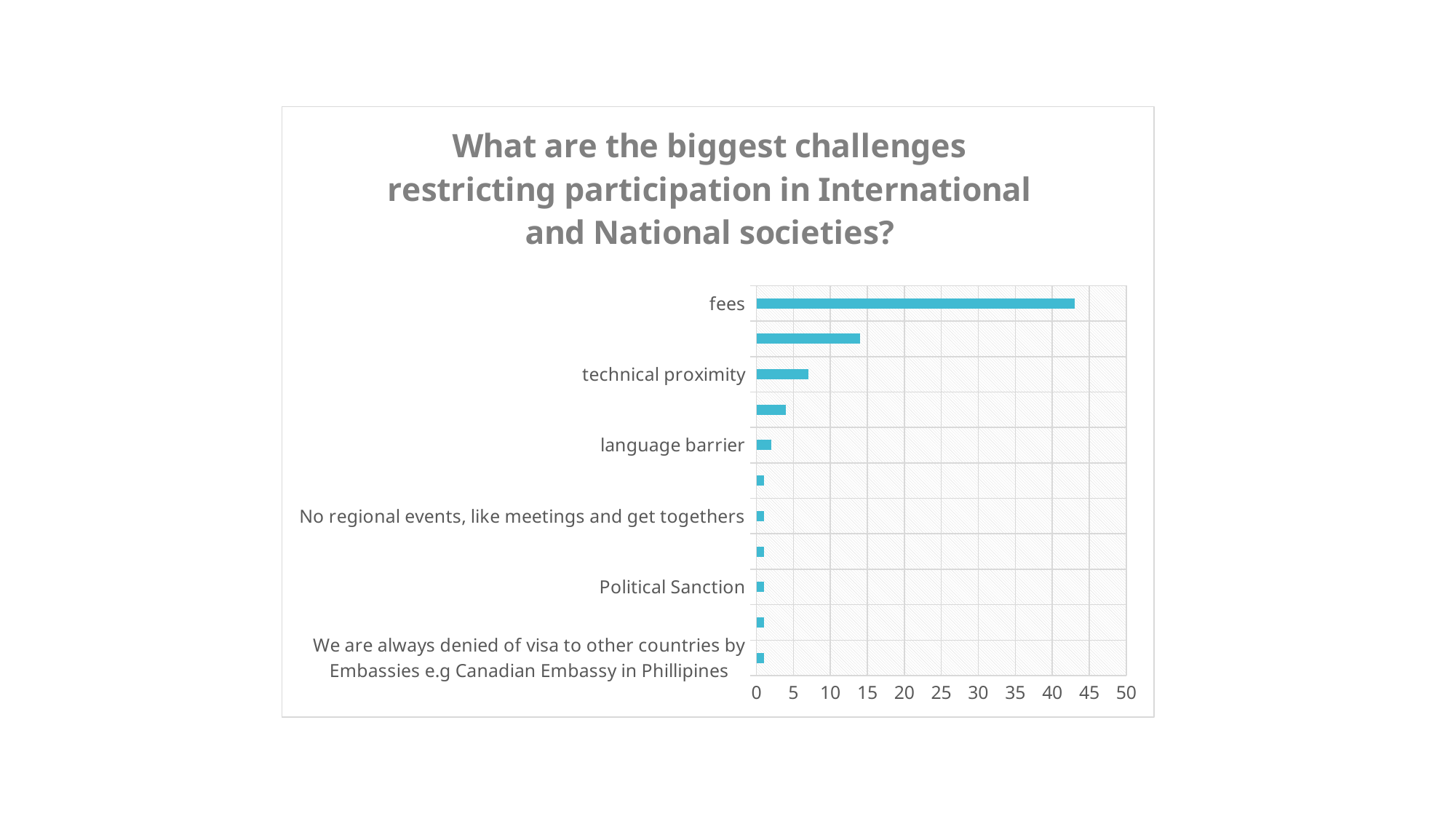
Is the value for technical proximity greater or less than 5? greater Which is larger, the value for fees or the value for technical proximity? fees Is the value for Political Sanction greater or less than 5? less What is the title of the chart? What are the biggest challenges restricting participation in International and National societies? Which is larger, the value for technical proximity or the value for language barrier? technical proximity What is the maximum value shown on the horizontal axis? 50 Which category has the highest value? fees Is the value for fees greater or less than 40? greater How many bars are plotted in the chart? 11 What kind of chart is shown on the slide? bar chart